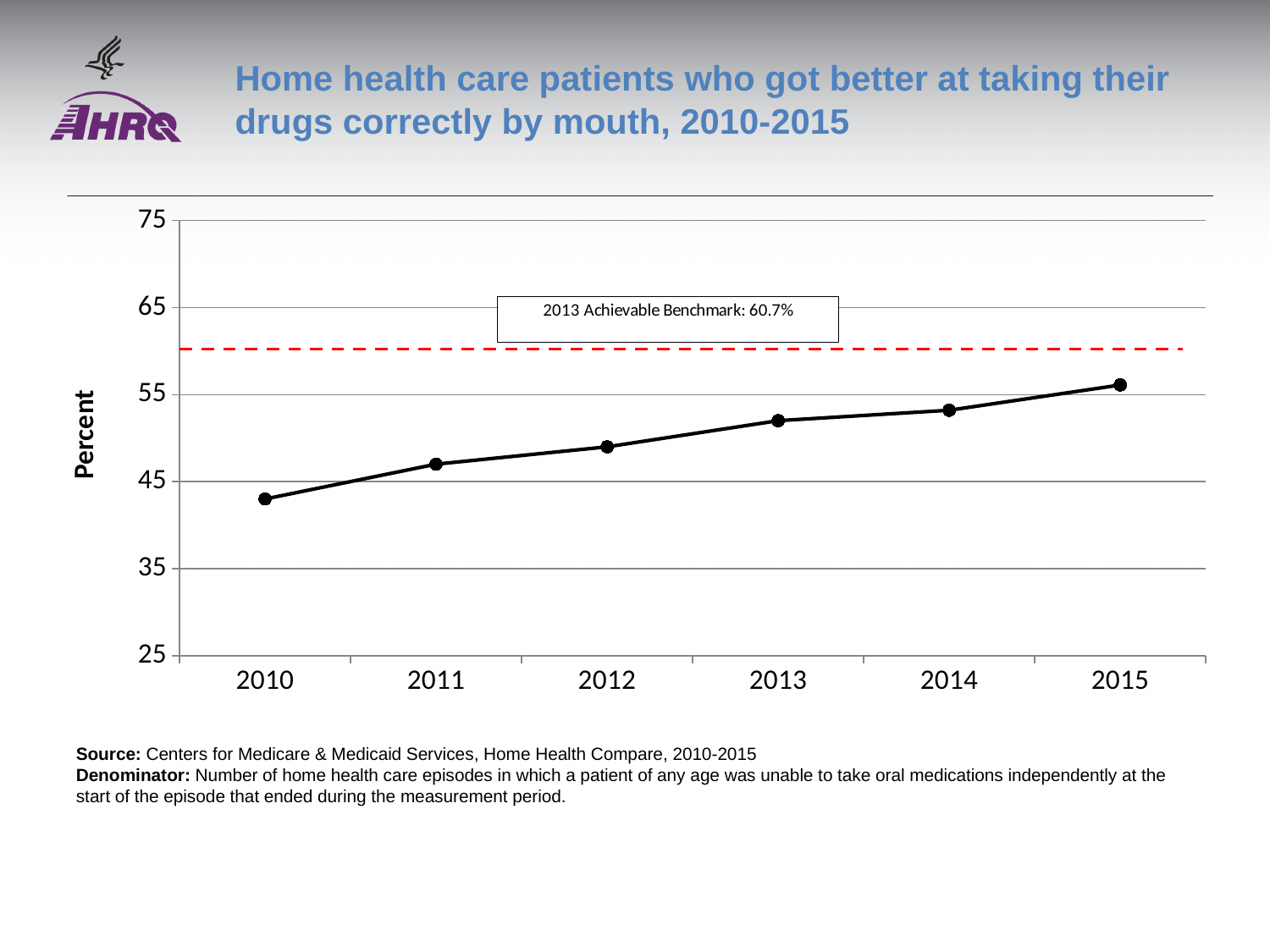
Which year has the lowest value? 2010 What kind of chart is shown on the slide? line chart Which year has the highest value? 2015 Which is larger, the value for 2012 or the value for 2014? 2014 What is the label on the y axis? Percent What is the 2013 Achievable Benchmark shown on the chart? 60.7% Do the values rise or fall from 2010 to 2015? rise How many years are plotted on the x axis? 6 Is the value for 2010 greater or less than 45? less Is the value for 2013 greater or less than 55? less Is the value for 2015 greater or less than 55? greater